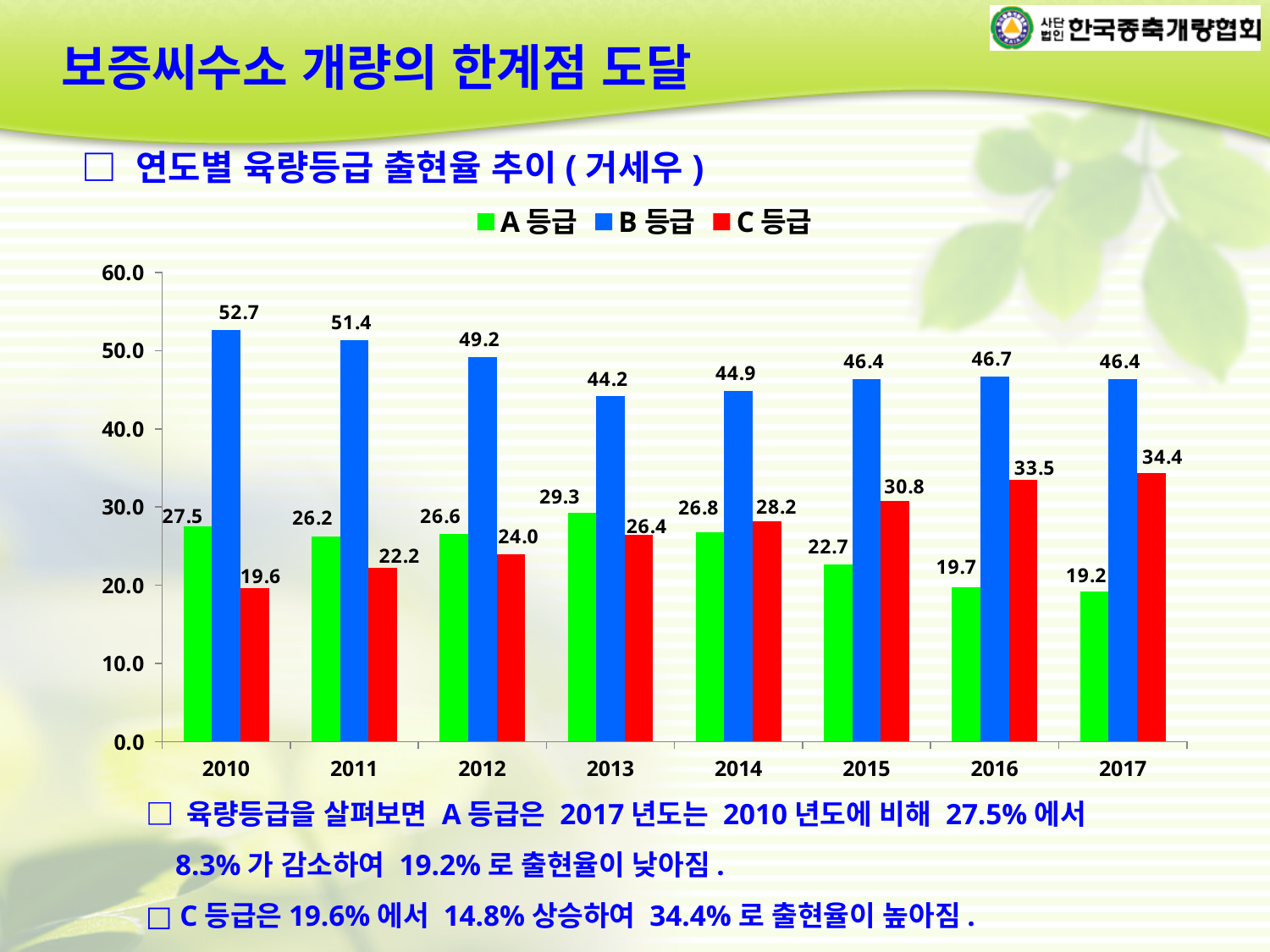
Which colour represents B 등급 in the chart? Blue Which is larger in 2016, the value for A 등급 or the value for C 등급? C 등급 What type of chart is shown on the slide? Bar chart Do the values for C 등급 rise or fall from 2010 to 2017? Rise In which year is the value for C 등급 the lowest? 2010 What is the value for A 등급 in 2013? 29.3 How many series does the legend list? 3 How many years are shown on the x axis? 8 What is the value for C 등급 in 2017? 34.4 What is the value for B 등급 in 2010? 52.7 What is the difference between the A 등급 values in 2010 and 2017? 8.3 In which year is the value for B 등급 the highest? 2010